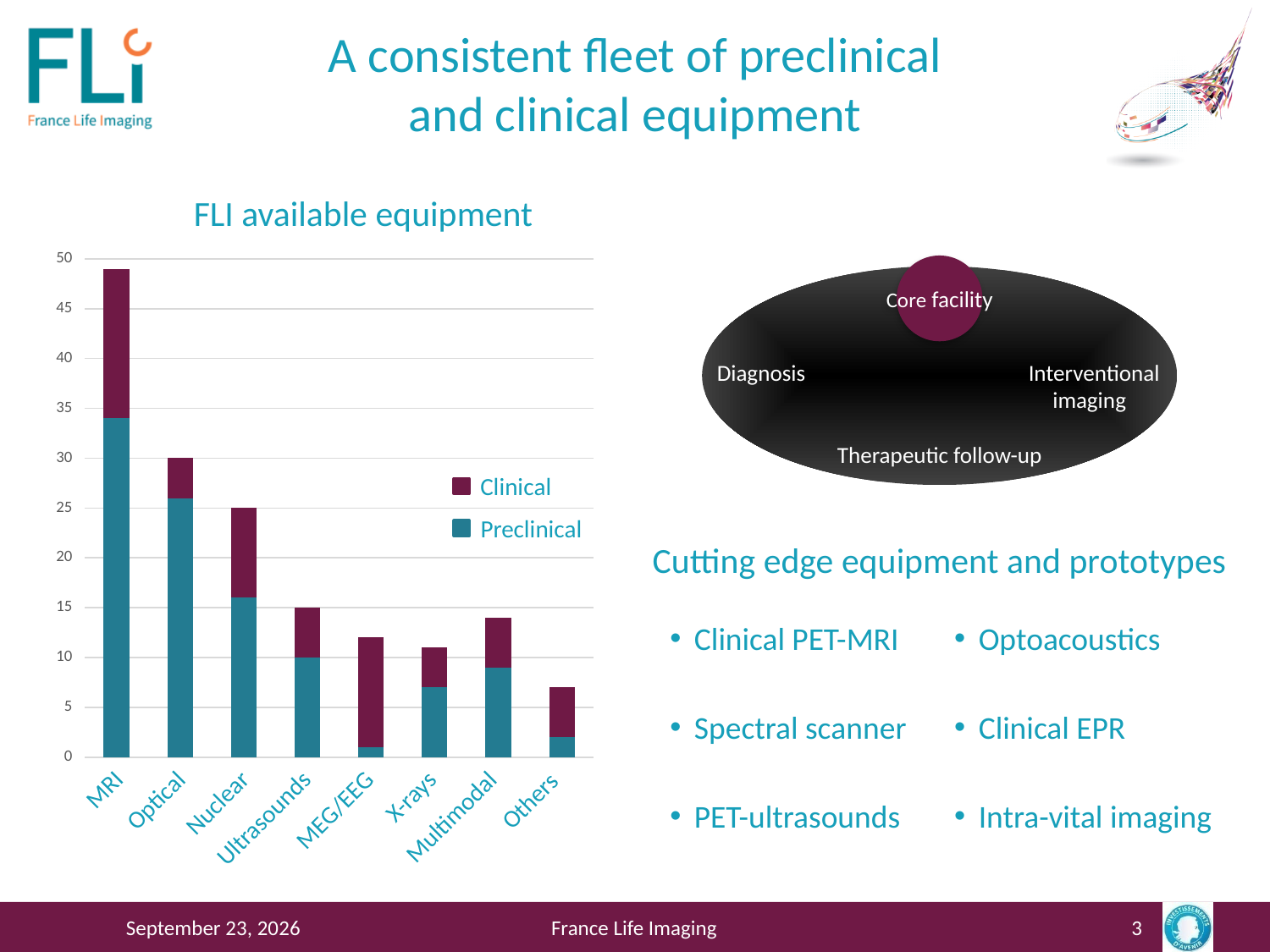
Is the total bar height for MRI greater or less than 45? greater Which has a taller total bar, Ultrasounds or Others? Ultrasounds What is the title of the chart on the slide? FLI available equipment What kind of chart is shown under the title 'FLI available equipment'? stacked bar chart Which equipment category has the tallest bar in the chart? MRI Which has a taller total bar, Optical or Nuclear? Optical How many equipment categories are shown on the x axis of the chart? 8 Is the total bar height for Multimodal greater or less than 15? less How many series does the chart legend list? 2 Is the total bar height for Others greater or less than 10? less Which equipment category has the shortest bar in the chart? Others What are the two series named in the chart legend? Clinical and Preclinical